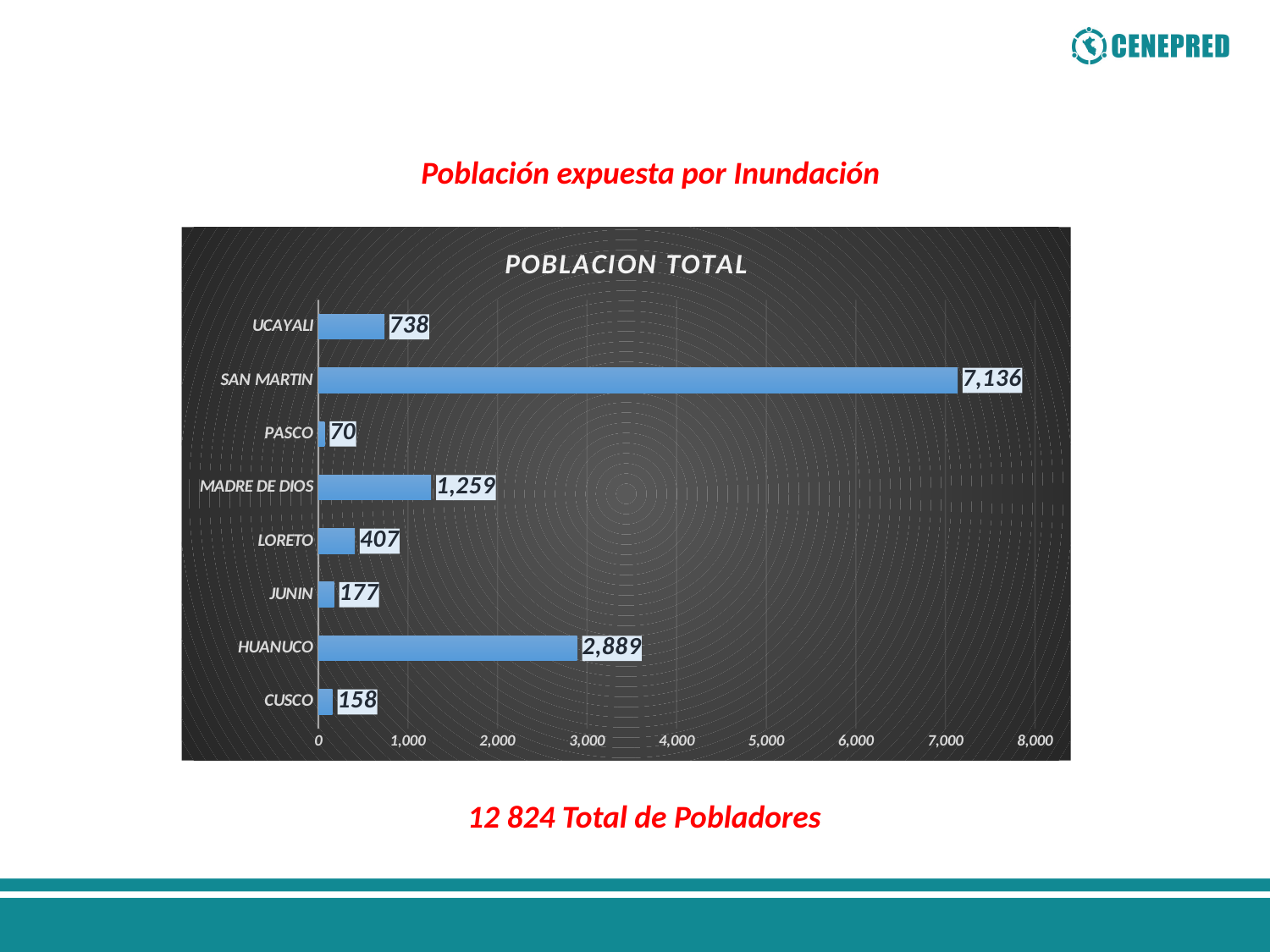
How many categories are shown in the chart? 8 What is the title of the chart? POBLACION TOTAL What is the value for SAN MARTIN? 7,136 Is the value for HUANUCO greater or less than 3,000? less Which category has the lowest value? PASCO Which is larger, the value for UCAYALI or the value for LORETO? UCAYALI What is the value for HUANUCO? 2,889 Which category has the highest value? SAN MARTIN What is the value for PASCO? 70 What kind of chart is shown? bar chart What is the difference between the values for SAN MARTIN and HUANUCO? 4,247 What is the value for MADRE DE DIOS? 1,259